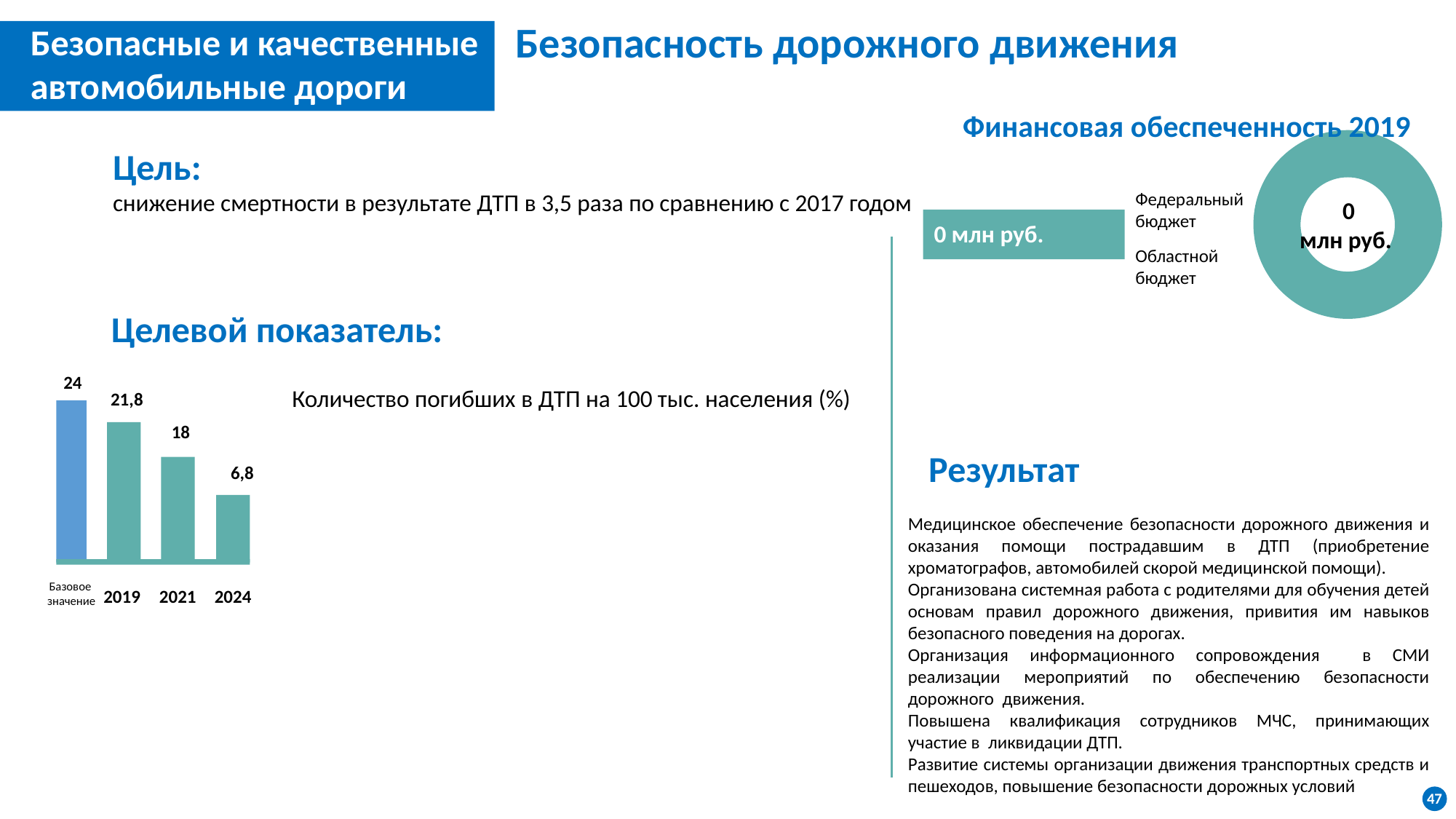
In the bar chart under 'Целевой показатель', what is the value for 2019? 21,8 In the bar chart under 'Целевой показатель', which is larger: the value for 2019 or the value for 2021? 2019 In the bar chart under 'Целевой показатель', which category has the lowest value? 2024 In the bar chart under 'Целевой показатель', what is the difference between the 'Базовое значение' and the 2019 value? 2,2 In the bar chart under 'Целевой показатель', what is the difference between the values for 2021 and 2024? 11,2 In the bar chart under 'Целевой показатель', which category has the highest value? Базовое значение In the bar chart under 'Целевой показатель', do the values rise or fall from left to right? fall In the bar chart under 'Целевой показатель', what is the value for 'Базовое значение'? 24 How many bars are in the bar chart under 'Целевой показатель'? 4 What kind of chart is shown under 'Финансовая обеспеченность 2019' on the right of the slide? donut chart In the bar chart under 'Целевой показатель', what is the value for 2024? 6,8 In the bar chart under 'Целевой показатель', what is the value for 2021? 18